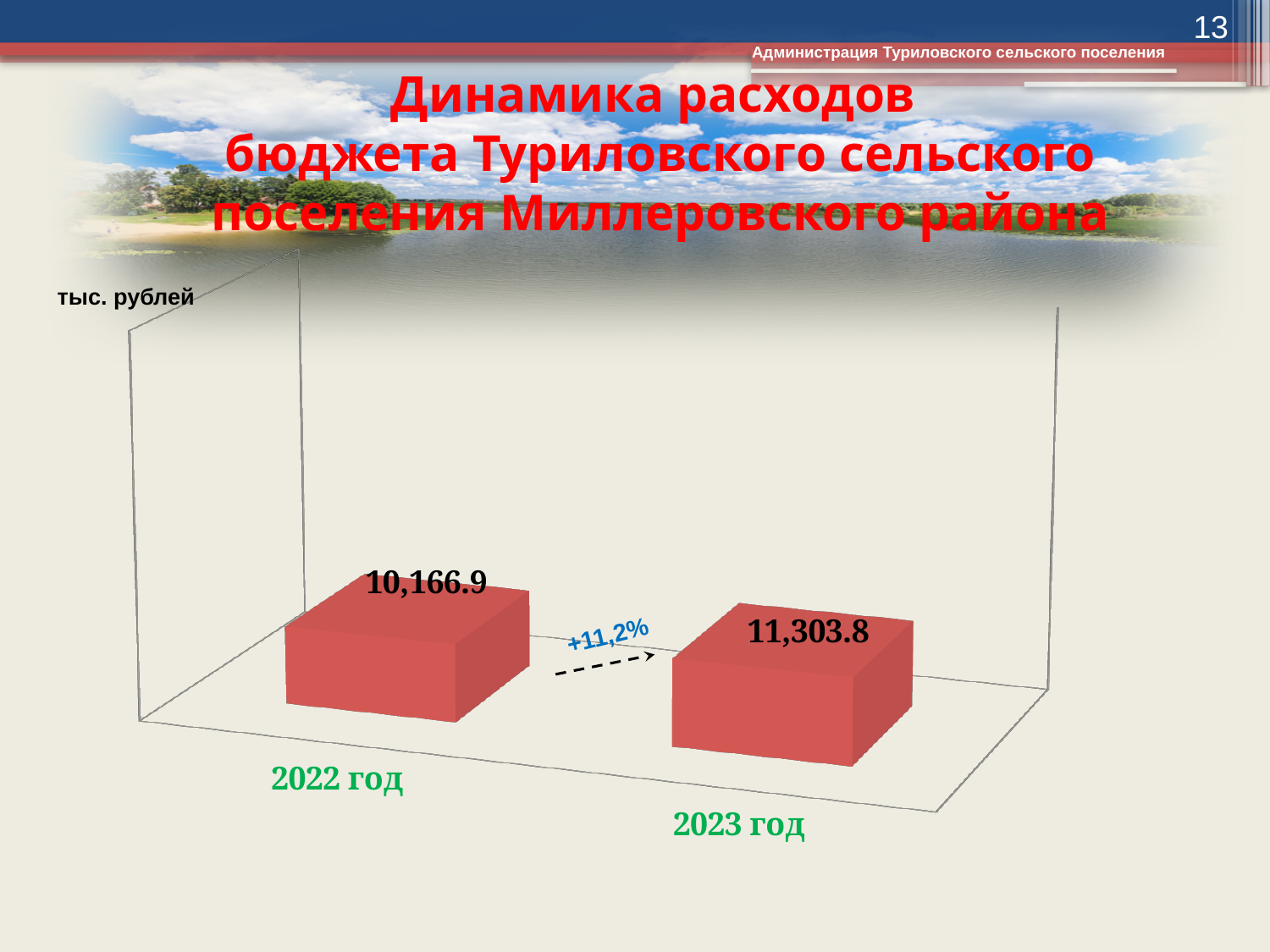
Do the values rise or fall from 2022 год to 2023 год? rise What is the value for 2023 год? 11,303.8 What unit is indicated for the chart values? тыс. рублей Is the value for 2023 год larger or smaller than the value for 2022 год? larger What is the difference between the values for 2023 год and 2022 год? 1,136.9 Which year has the lower value? 2022 год What kind of chart is shown on the slide? bar chart What is the value for 2022 год? 10,166.9 What percentage change is shown between 2022 год and 2023 год? +11,2% How many categories are plotted on the chart? 2 Which year has the higher value? 2023 год